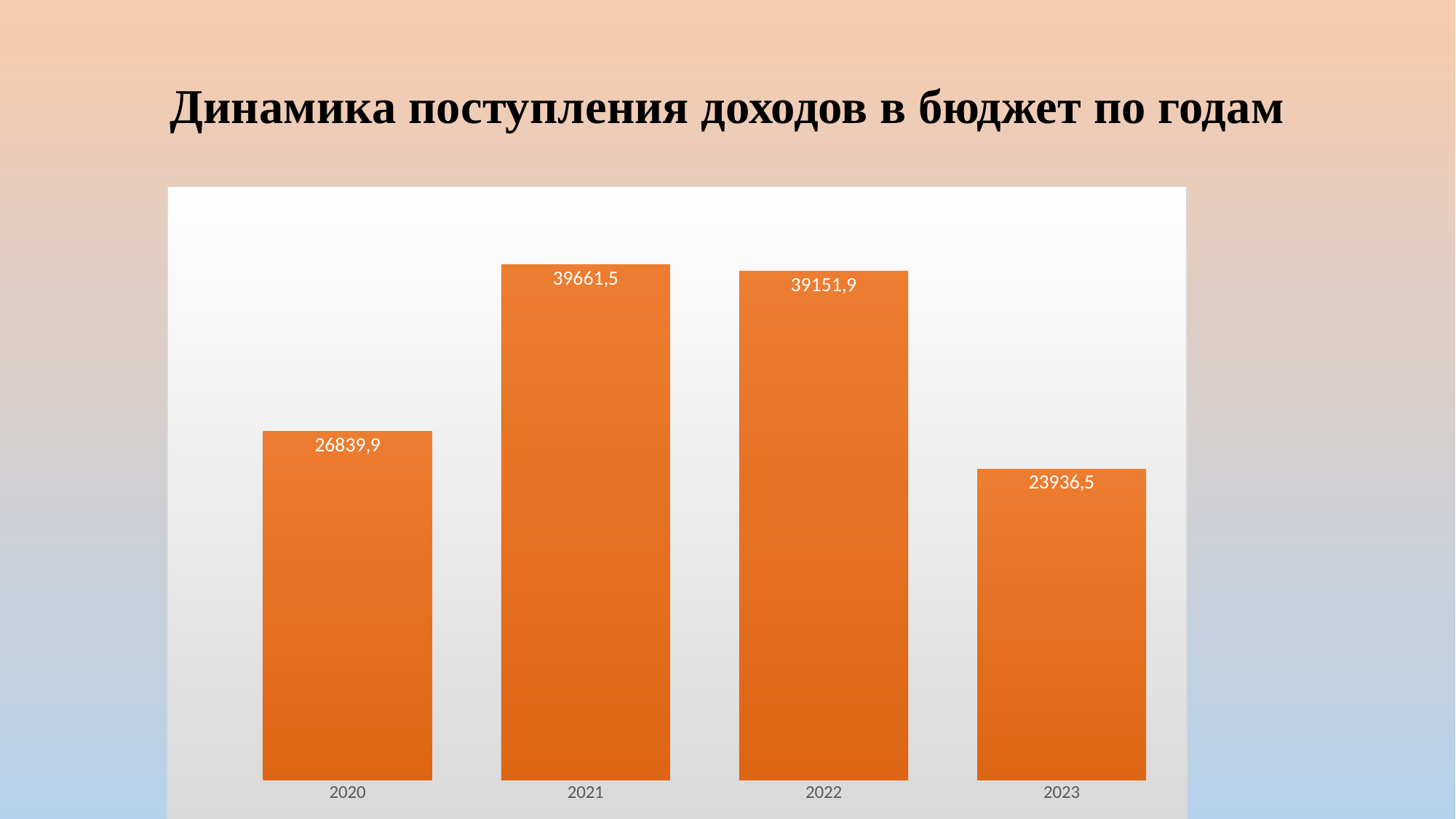
Which year has the highest value? 2021 What is the value for 2023? 23936,5 What is the difference between the values for 2021 and 2022? 509,6 What is the difference between the values for 2020 and 2023? 2903,4 How many years are shown on the chart? 4 What is the value for 2022? 39151,9 What is the value for 2020? 26839,9 What kind of chart is shown on the slide? bar chart What is the value for 2021? 39661,5 Which year has the lowest value? 2023 What is the title of the chart on the slide? Динамика поступления доходов в бюджет по годам Which is larger, the value for 2020 or the value for 2023? 2020